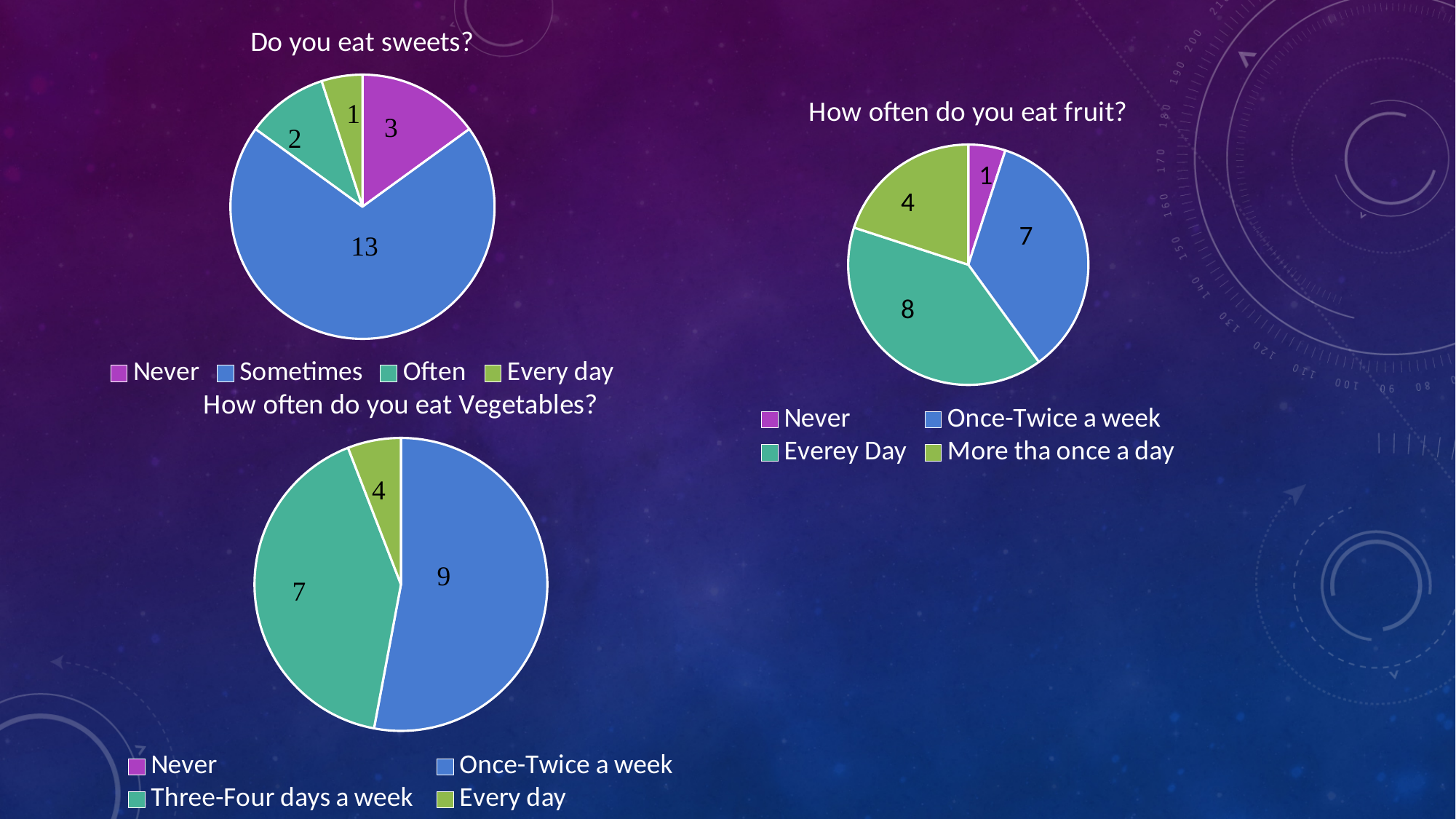
In the 'Do you eat sweets?' chart, how many categories does the legend list? 4 In the 'How often do you eat fruit?' chart, what share of the total does Everey Day represent? 40% In the 'Do you eat sweets?' chart, which category has the smallest slice? Every day In the 'How often do you eat fruit?' chart, what is the value for Once-Twice a week? 7 What kind of chart is 'How often do you eat Vegetables?'? Pie chart In the 'Do you eat sweets?' chart, what is the value for Sometimes? 13 In the 'How often do you eat Vegetables?' chart, what colour is the Every day slice? Green In the 'Do you eat sweets?' chart, what is the difference between the Never and Often values? 1 In the 'How often do you eat Vegetables?' chart, what is the value for Three-Four days a week? 7 In the 'How often do you eat fruit?' chart, what is the total of all slices? 20 In the 'How often do you eat Vegetables?' chart, which is larger, Once-Twice a week or Every day? Once-Twice a week In the 'How often do you eat fruit?' chart, which category has the largest slice? Everey Day